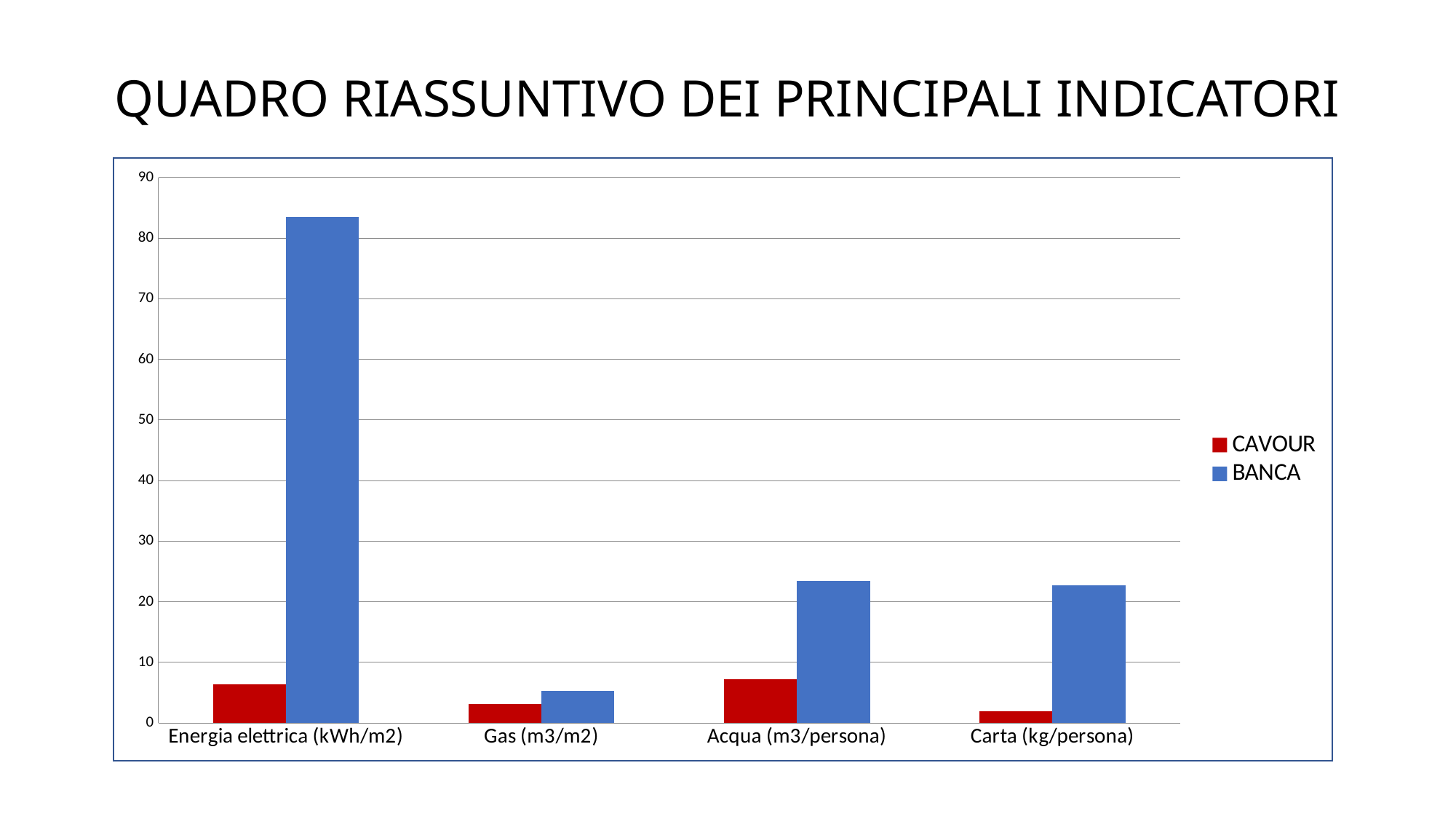
Is the BANCA value for Energia elettrica (kWh/m2) greater or less than 80? greater Is the BANCA value for Acqua (m3/persona) greater or less than 20? greater Which category has the lowest BANCA value? Gas (m3/m2) Which category has the lowest CAVOUR value? Carta (kg/persona) How many series does the legend list? 2 For Acqua (m3/persona), which series has the larger value, CAVOUR or BANCA? BANCA What kind of chart is shown on the slide? bar chart How many categories are shown on the x axis? 4 Is the BANCA value for Gas (m3/m2) greater or less than 10? less Which category has the highest BANCA value? Energia elettrica (kWh/m2) Which colour represents the CAVOUR series in the legend? red